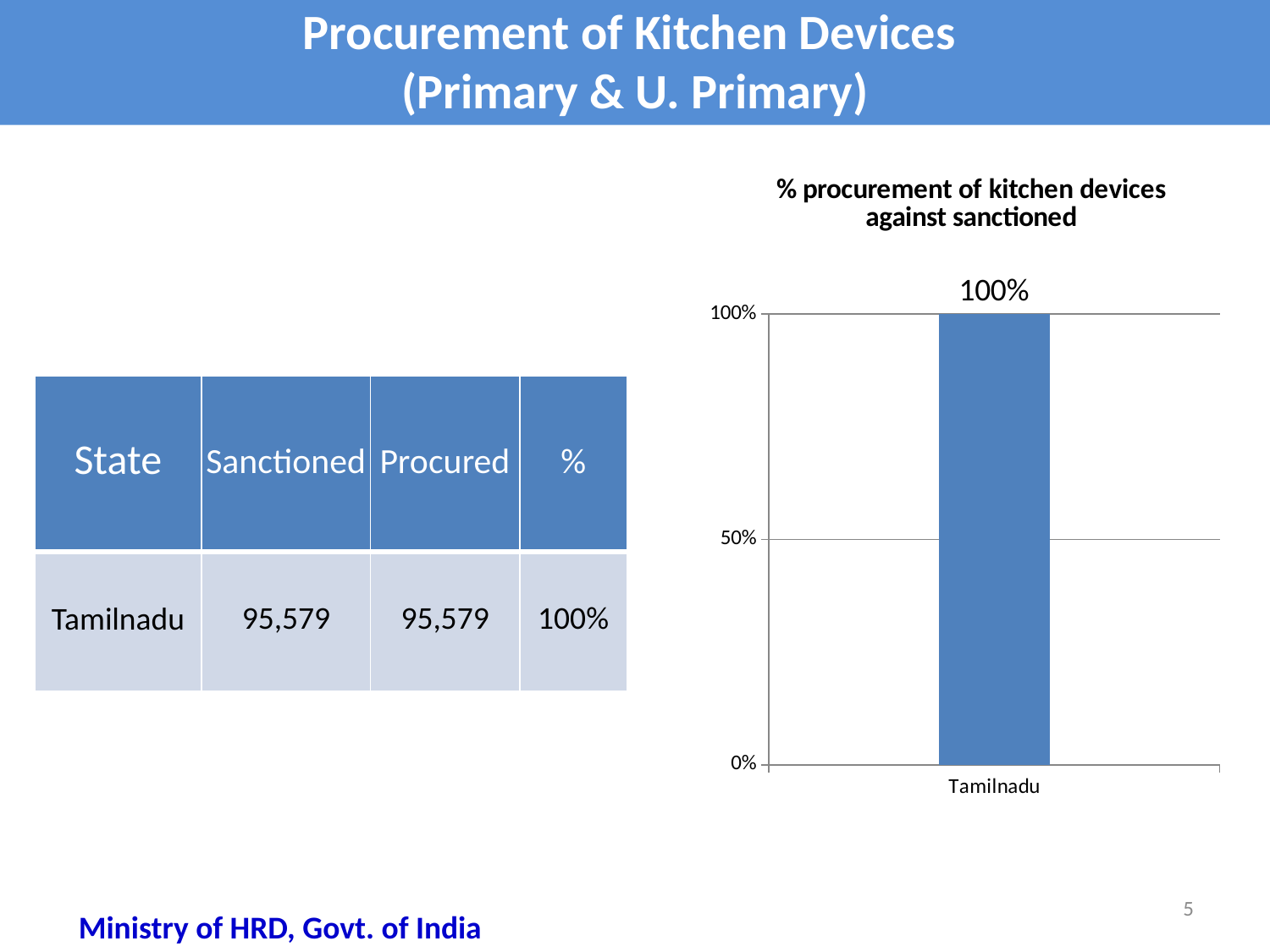
Is the value for Tamilnadu greater or less than 50%? greater How many categories are plotted in the chart? 1 What kind of chart is shown on the slide? bar chart Which category is shown on the x axis of the chart? Tamilnadu What is the title of the chart? % procurement of kitchen devices against sanctioned What is the highest value shown on the chart's y axis? 100% What is the value for Tamilnadu in the chart? 100%